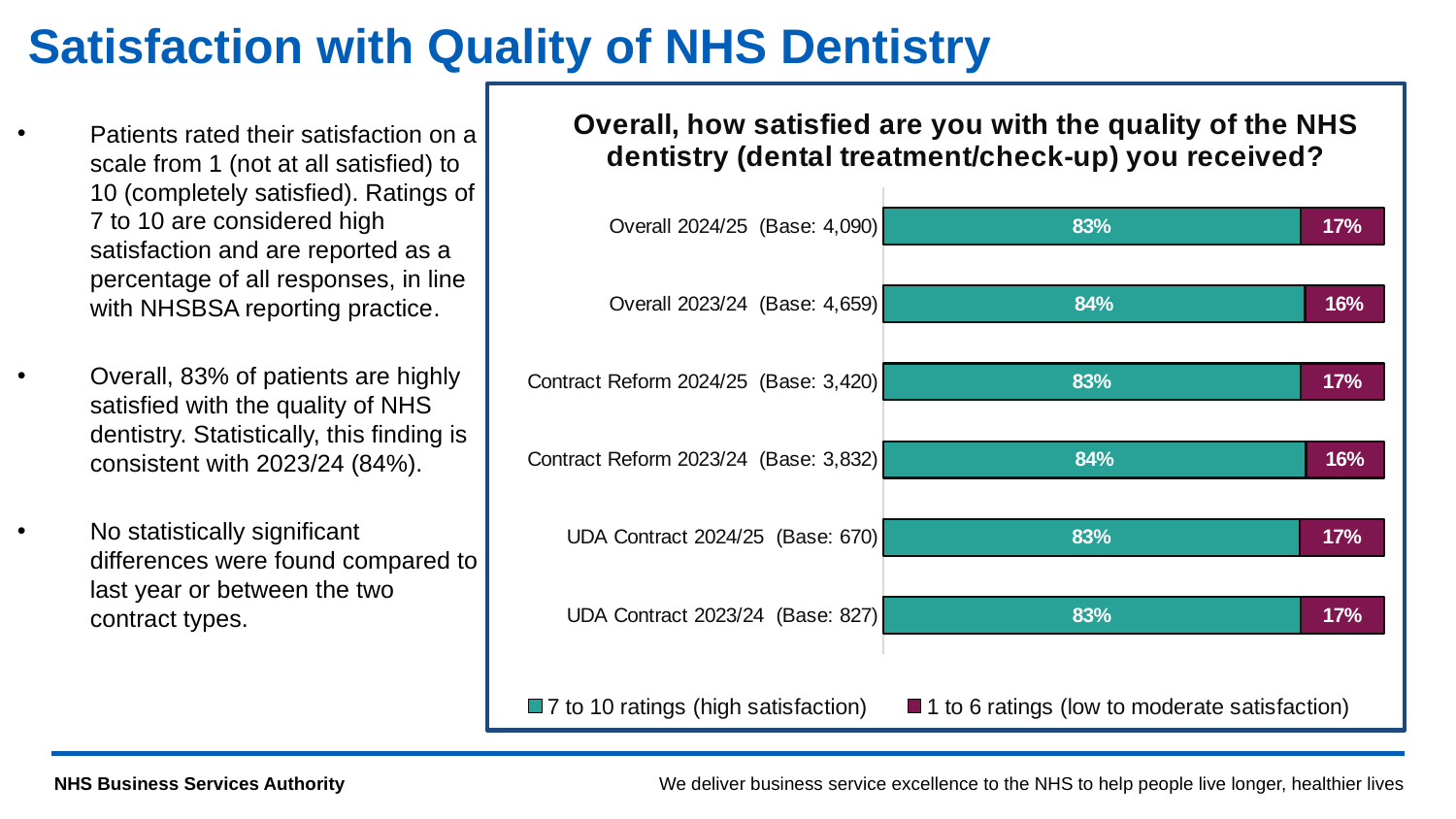
What is the base (number of respondents) shown for UDA Contract 2023/24? 827 How many series does the legend list? 2 What percentage of Overall 2023/24 respondents gave 1 to 6 ratings (low to moderate satisfaction)? 16% What is the total of the two segments in the UDA Contract 2024/25 bar? 100% How many category bars are shown in the chart? 6 Which legend entry is represented by the teal (green) segments? 7 to 10 ratings (high satisfaction) What is the high satisfaction (7 to 10 ratings) value for Contract Reform 2023/24? 84% What is the difference between the 7 to 10 ratings value for Overall 2023/24 and Overall 2024/25? 1 percentage point What percentage of Overall 2024/25 respondents gave 7 to 10 ratings (high satisfaction)? 83% What is the 1 to 6 ratings value for UDA Contract 2024/25? 17% What type of chart is shown on the slide? Stacked bar chart Which has a higher 7 to 10 ratings value: Contract Reform 2024/25 or Contract Reform 2023/24? Contract Reform 2023/24